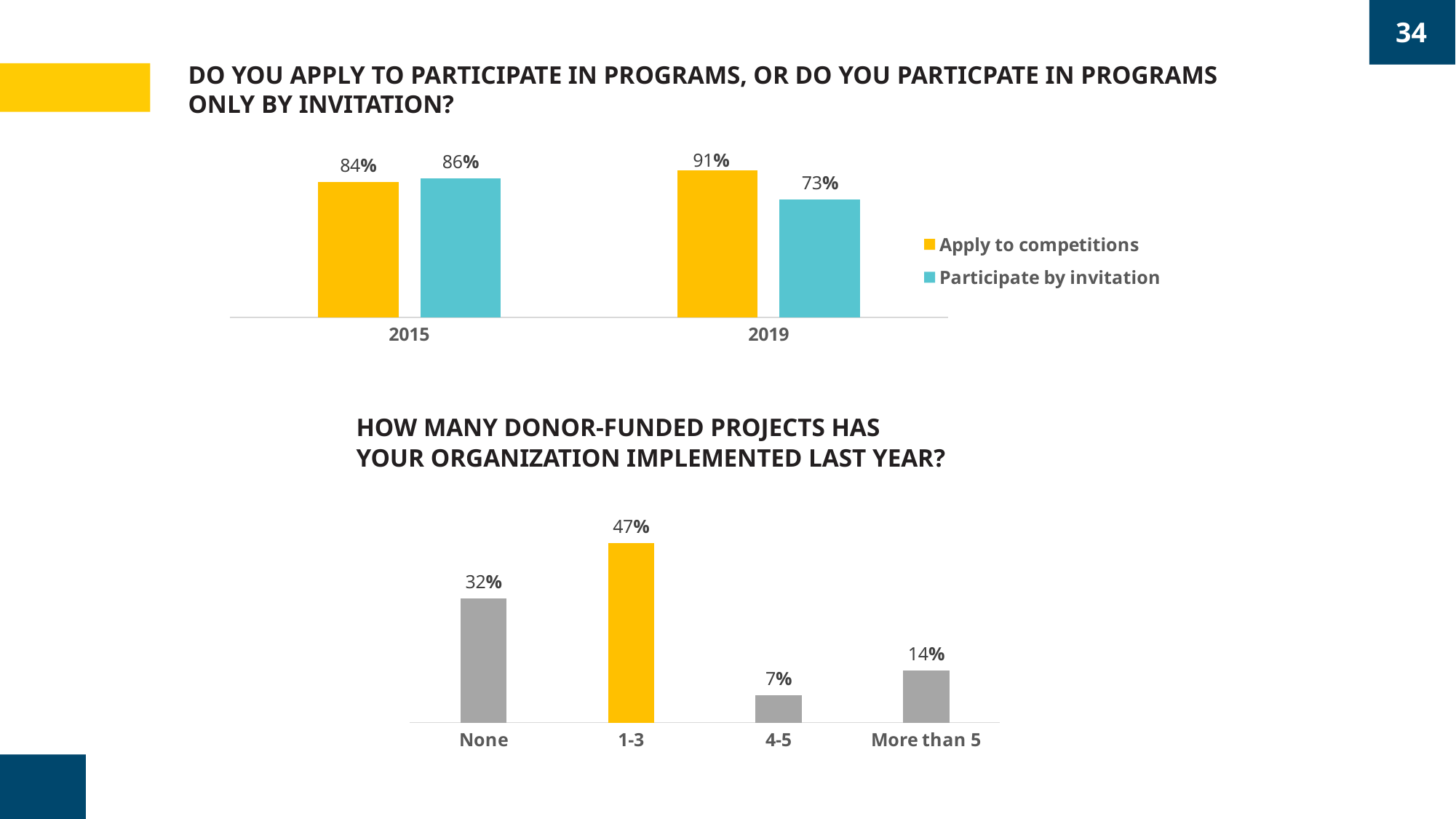
In the bottom chart, what percentage of organizations implemented 1-3 donor-funded projects last year? 47% In the top chart, which is larger in 2015: 'Apply to competitions' or 'Participate by invitation'? Participate by invitation In the top chart, what is the difference between 'Apply to competitions' and 'Participate by invitation' in 2019? 18% In the top chart, what percentage applied to competitions in 2019? 91% In the top chart, did the 'Participate by invitation' value rise or fall from 2015 to 2019? fall How many categories are shown in the bottom chart? 4 What kind of chart is the bottom chart? bar chart In the top chart, what percentage participated by invitation in 2015? 86% In the bottom chart, which category has the highest value? 1-3 In the bottom chart, which category has the lowest value? 4-5 How many series does the legend of the top chart list? 2 In the bottom chart, what is the difference between 'None' and 'More than 5'? 18%